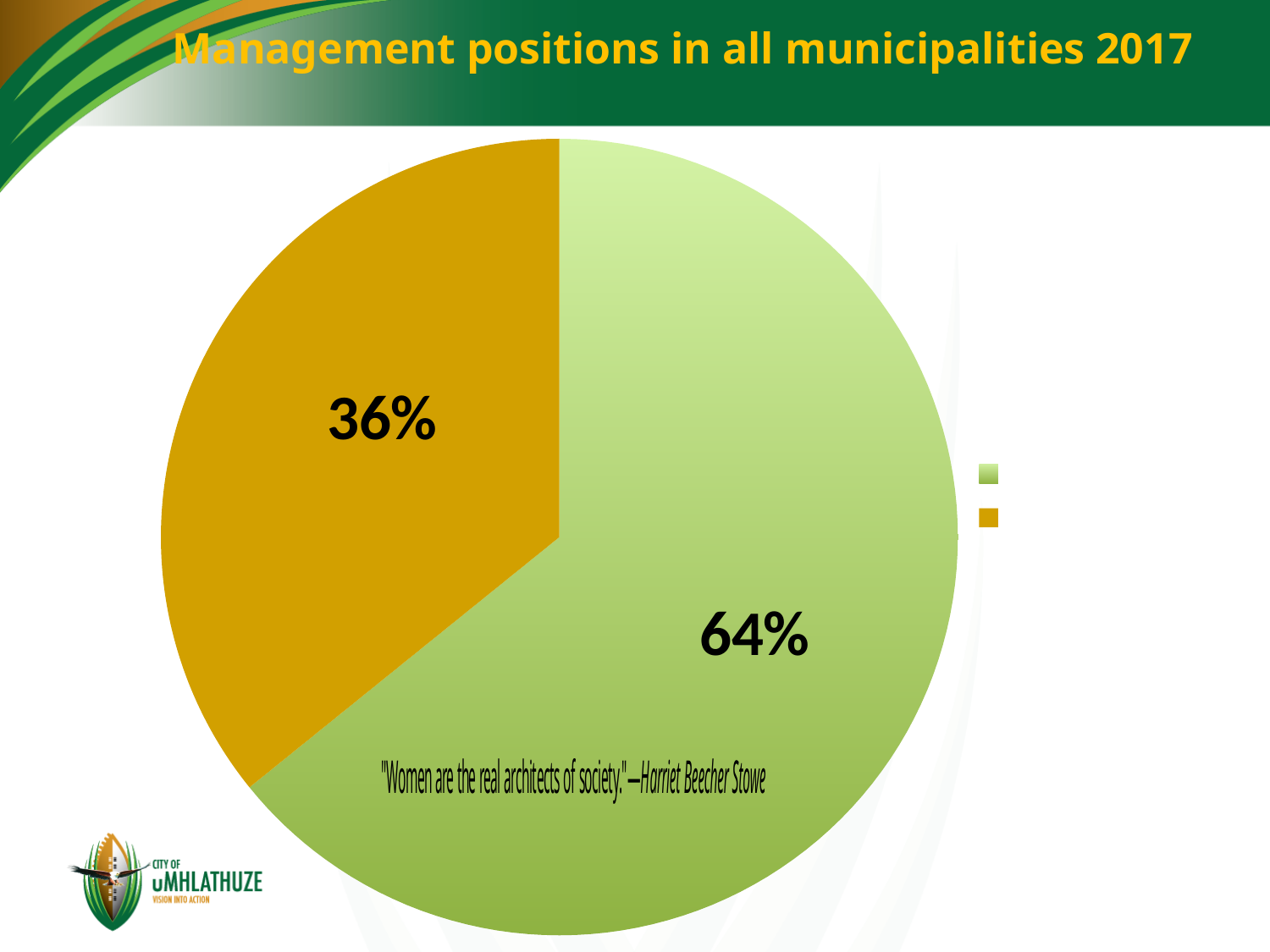
What percentage is shown on the green slice of the pie chart? 64% What percentage is shown on the gold slice of the pie chart? 36% What is the difference in percentage points between the green slice and the gold slice? 28 percentage points Which is larger, the green slice or the gold slice? the green slice What is the title of the slide containing the pie chart? Management positions in all municipalities 2017 How many slices does the pie chart have? 2 Which slice of the pie chart is the largest? the green slice (64%) What kind of chart is shown on the slide? pie chart How many entries does the legend to the right of the pie chart show? 2 Which slice of the pie chart is the smallest? the gold slice (36%) Is the green slice's share greater or less than 50%? greater What do the two slices of the pie chart add up to? 100%